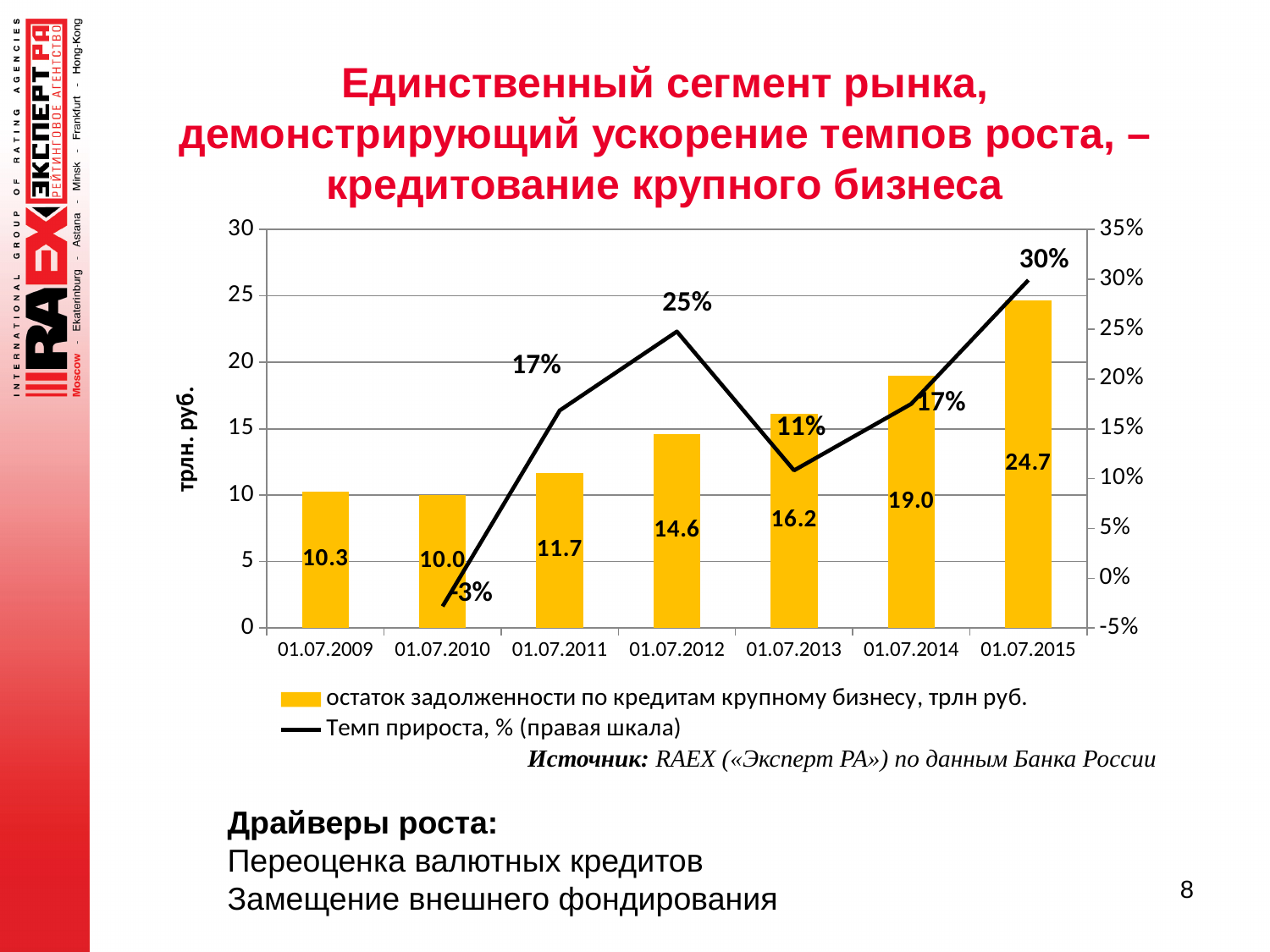
How many series does the legend list? 2 Which date has the lowest bar value? 01.07.2010 What growth rate (Темп прироста) is shown for 01.07.2012? 25% What kind of chart is this? Combined bar and line chart Which date has the highest bar value? 01.07.2015 What is the value of the bar for 01.07.2013? 16.2 Which is larger: the bar value for 01.07.2011 or for 01.07.2012? 01.07.2012 How many dates are shown on the x axis? 7 What growth rate (Темп прироста) is shown for 01.07.2010? -3% Is the bar value for 01.07.2014 greater or less than 20? less What is the difference between the bar values for 01.07.2015 and 01.07.2014? 5.7 Do the bar values rise or fall from 01.07.2010 to 01.07.2015? rise